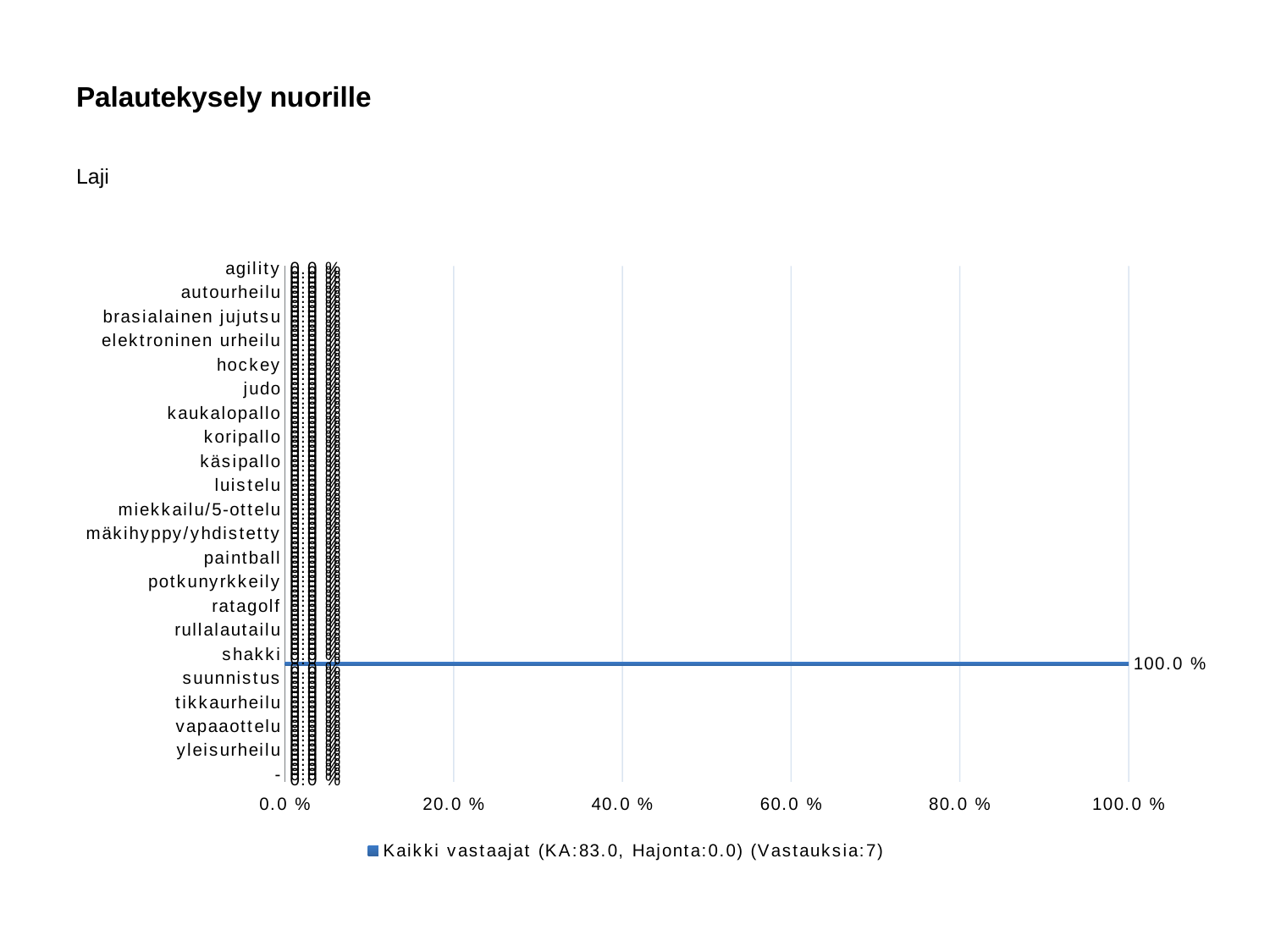
What is the highest value shown by a data label on the chart? 100.0 % Is the value for yleisurheilu greater or less than 20.0 %? less What is the title of the chart? Laji What is the maximum value shown on the horizontal axis? 100.0 % Is the value for judo greater or less than 20.0 %? less Is the value for agility greater or less than 20.0 %? less What kind of chart is shown on the slide? bar chart How many series does the legend list? 1 What is the legend entry for the series shown? Kaikki vastaajat (KA:83.0, Hajonta:0.0) (Vastauksia:7) How many responses (Vastauksia) does the legend report? 7